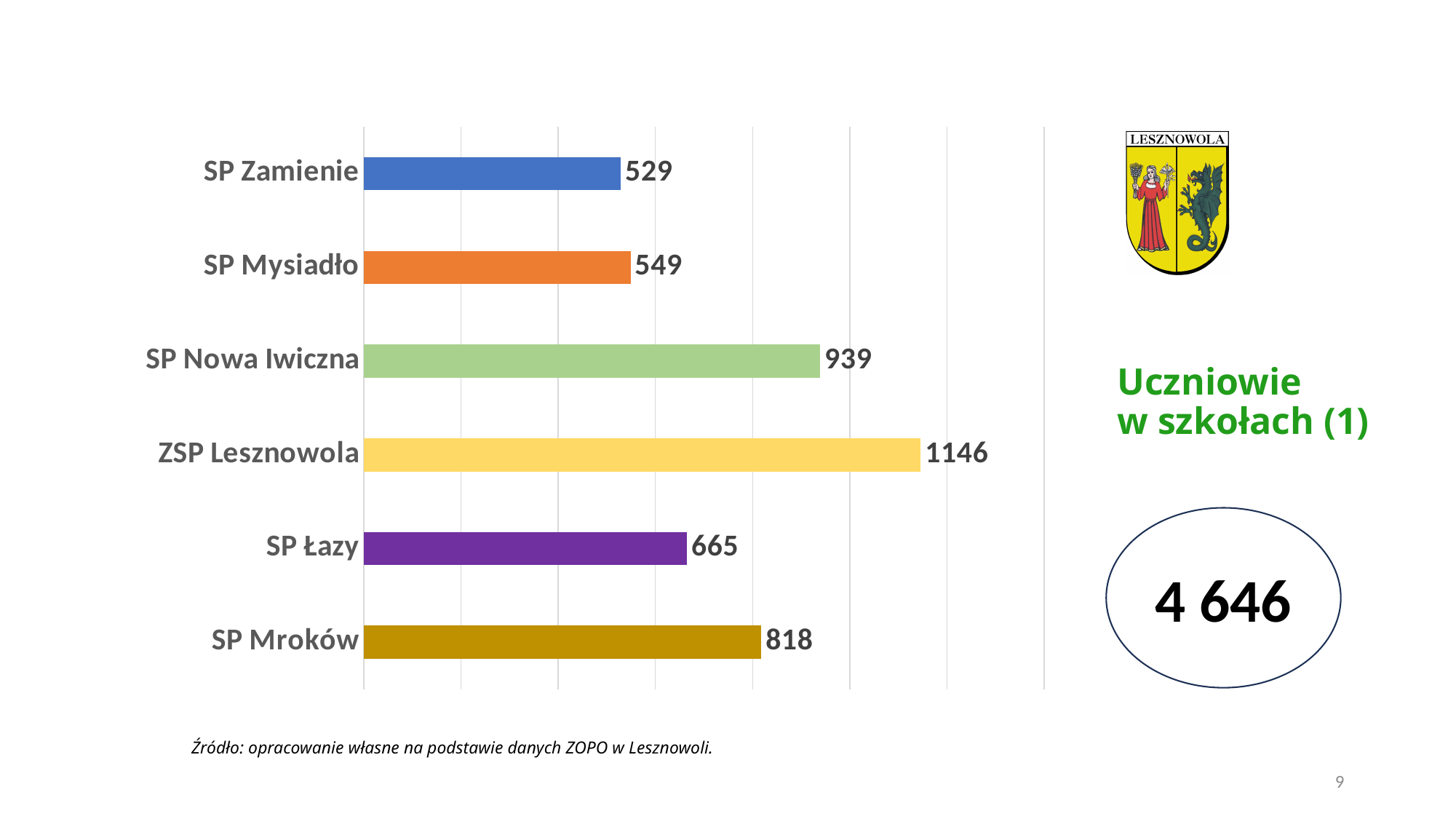
What is the difference between the values for ZSP Lesznowola and SP Nowa Iwiczna? 207 What is the value shown for ZSP Lesznowola? 1146 How many students does SP Zamienie have? 529 Which is larger, the value for SP Łazy or the value for SP Mroków? SP Mroków What is the value shown for SP Mroków? 818 Which school has the highest value on the chart? ZSP Lesznowola How many schools are shown on the chart? 6 What is the difference between the values for SP Mysiadło and SP Zamienie? 20 Which school has the lowest value on the chart? SP Zamienie What kind of chart is shown on the slide? bar chart Which is larger, the value for SP Nowa Iwiczna or the value for SP Łazy? SP Nowa Iwiczna What total number is shown in the circle next to the chart? 4 646